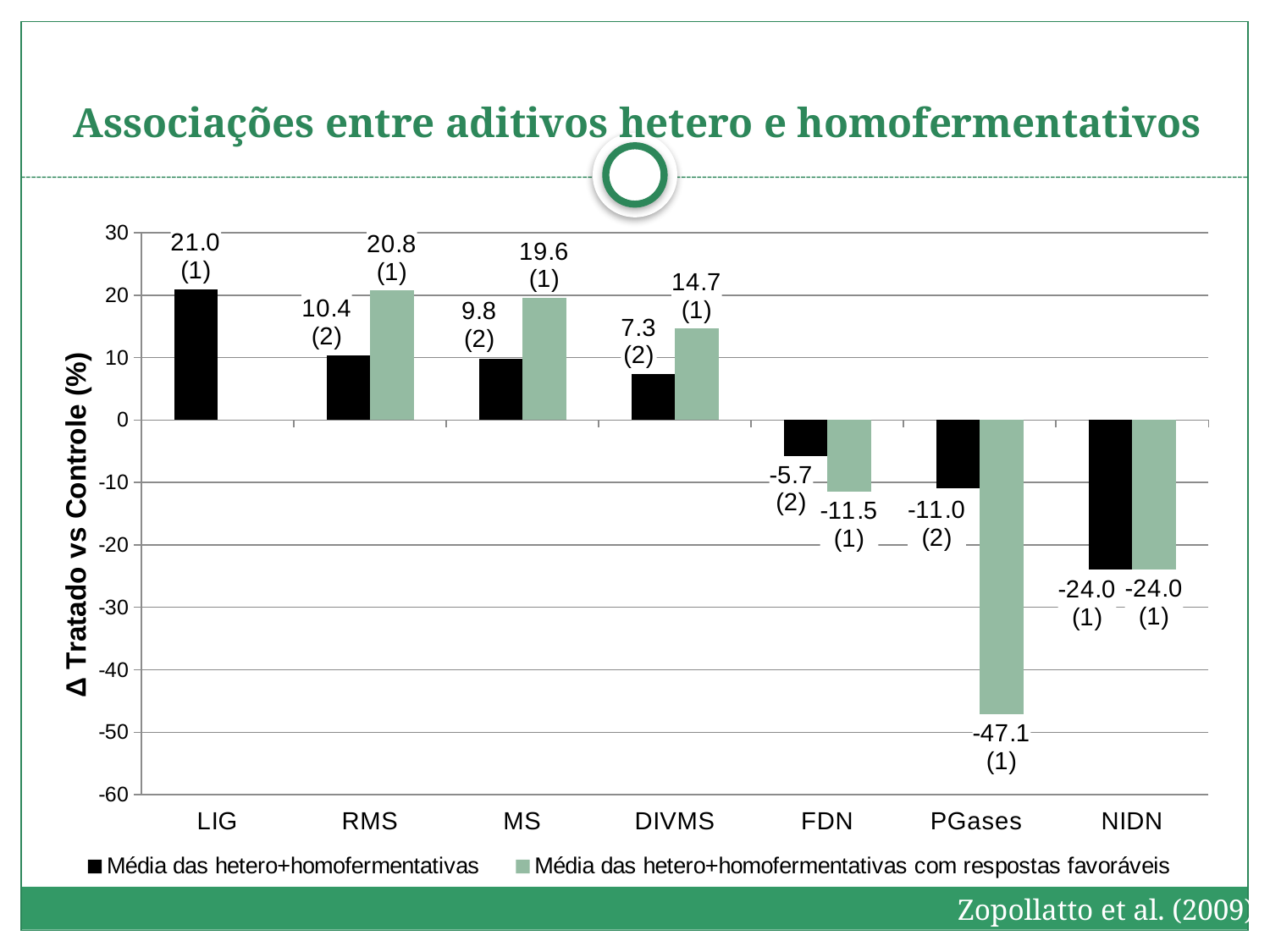
What is the value for DIVMS in the 'Média das hetero+homofermentativas' series? 7.3 What is the difference between the 'Média das hetero+homofermentativas com respostas favoráveis' value and the 'Média das hetero+homofermentativas' value for RMS? 10.4 What colour are the bars for the 'Média das hetero+homofermentativas com respostas favoráveis' series? green What type of chart is shown on the slide? bar chart How many series does the legend list? 2 For FDN, which series has the larger value: 'Média das hetero+homofermentativas' or 'Média das hetero+homofermentativas com respostas favoráveis'? Média das hetero+homofermentativas Which category has the highest value in the 'Média das hetero+homofermentativas' series? LIG What is the value for PGases in the 'Média das hetero+homofermentativas com respostas favoráveis' series? -47.1 How many categories are shown on the x axis of the chart? 7 Which category has the lowest value in the 'Média das hetero+homofermentativas com respostas favoráveis' series? PGases What is the value for LIG in the 'Média das hetero+homofermentativas' series? 21.0 What is the label of the y axis of the chart? Δ Tratado vs Controle (%)